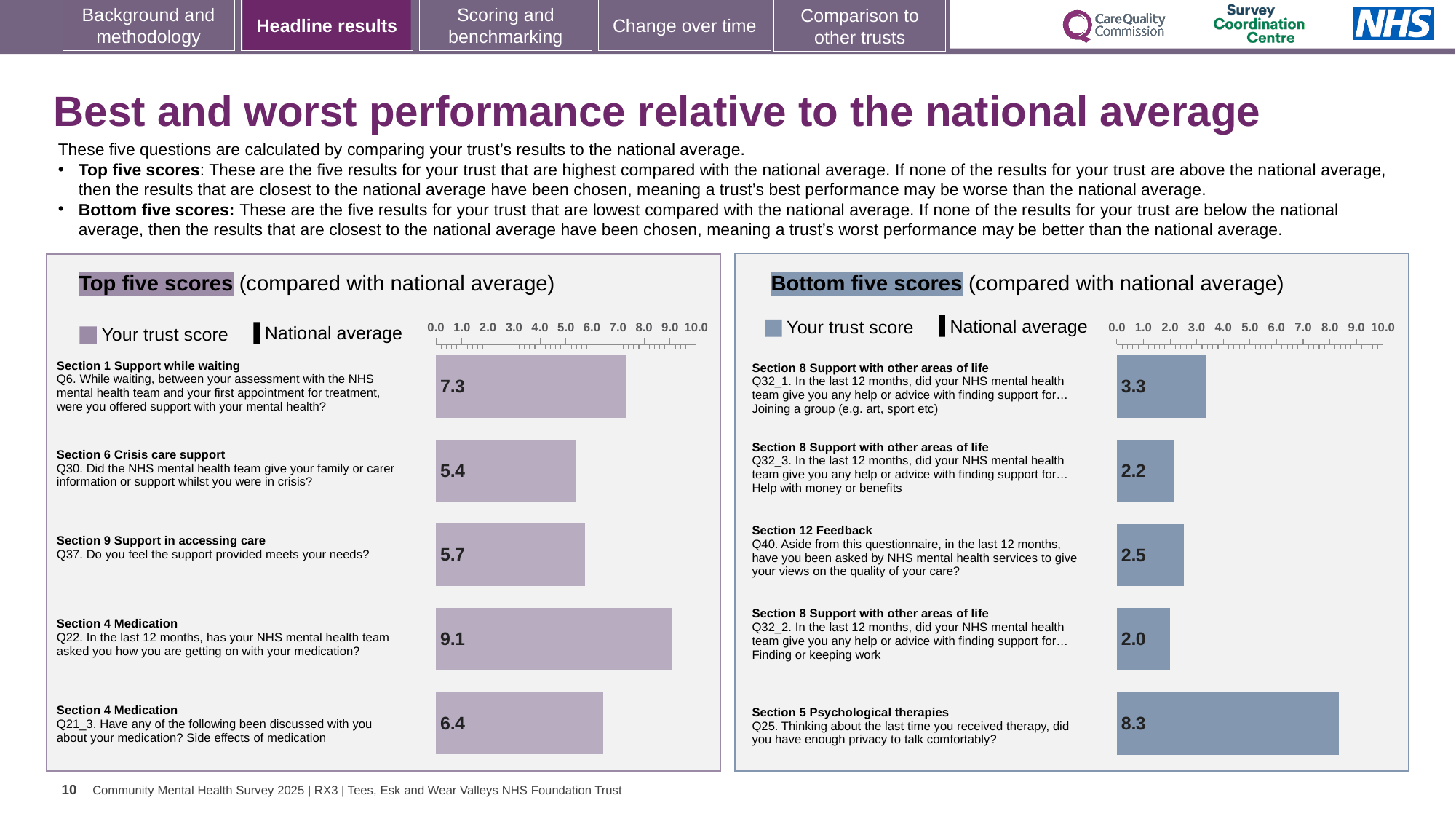
How many questions are plotted in the Top five scores chart? 5 In the Top five scores chart, what is the trust score for Q22 (asked how you are getting on with your medication)? 9.1 In the Bottom five scores chart, what is the trust score for Q32_2 (help finding or keeping work)? 2.0 What kind of chart is the Bottom five scores chart? Bar chart In the Top five scores chart, which question has the highest trust score? Q22 In the Bottom five scores chart, which question has the lowest trust score? Q32_2 In the Top five scores chart, what is the trust score for Q30 (family or carer given information or support whilst in crisis)? 5.4 In the Top five scores chart, what is the difference between the trust scores for Q6 and Q37? 1.6 In the Bottom five scores chart, what is the difference between the trust scores for Q32_1 and Q32_3? 1.1 How many entries does the legend of the Top five scores chart list? 2 In the Bottom five scores chart, which has the larger trust score, Q40 or Q32_3? Q40 In the Bottom five scores chart, what is the trust score for Q25 (enough privacy to talk comfortably during therapy)? 8.3